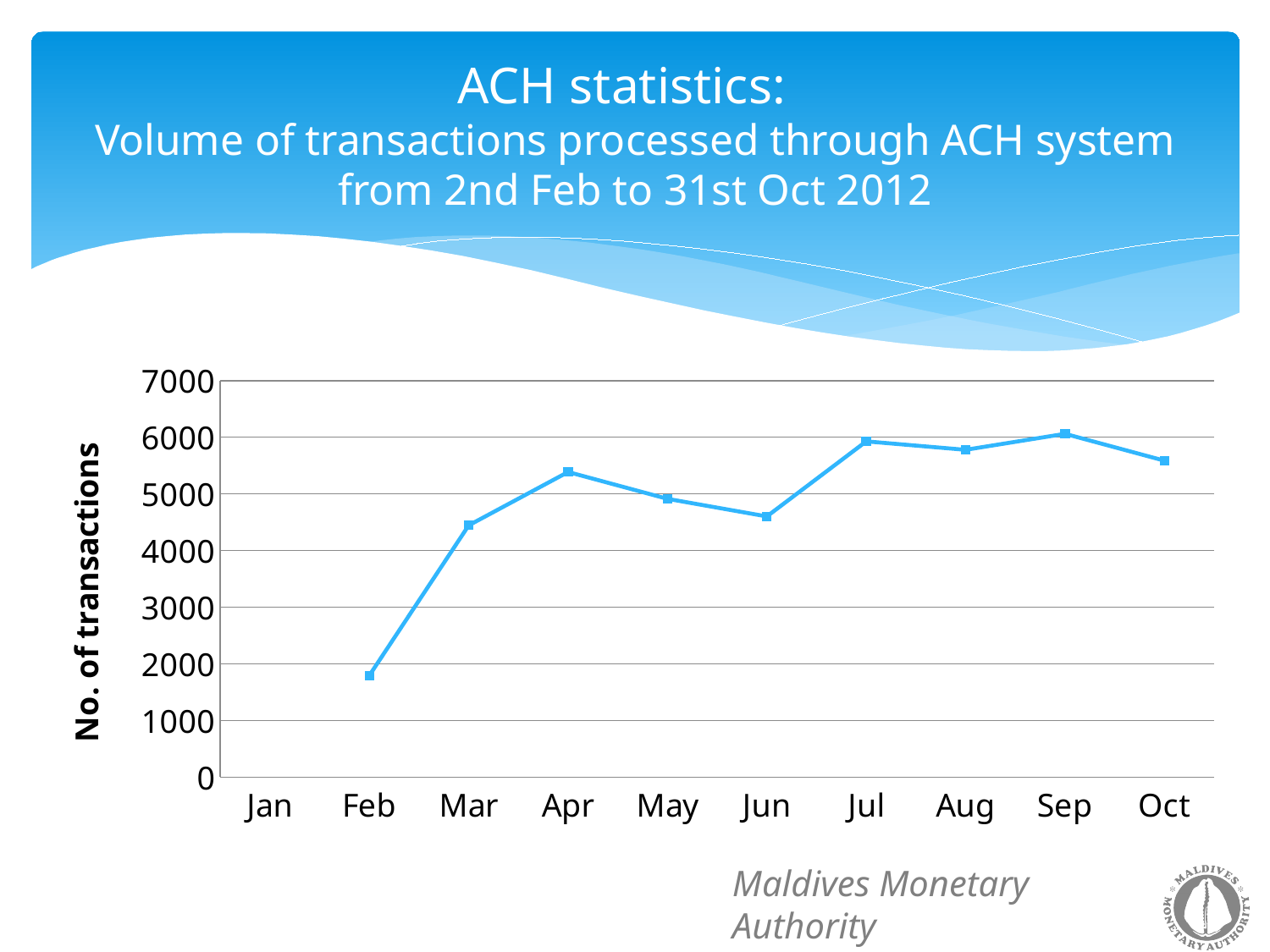
Is the value for Jun greater or less than 5000? less What kind of chart is shown on the slide? line chart Do the values rise or fall from Feb to Apr? rise Which is larger, the value for Jun or the value for Jul? Jul Is the value for Apr greater or less than 5000? greater How many data points are plotted on the line? 9 Is the value for Feb greater or less than 2000? less What is the title of the vertical axis? No. of transactions Which month has the lowest number of transactions on the chart? Feb Which is larger, the value for Apr or the value for May? Apr